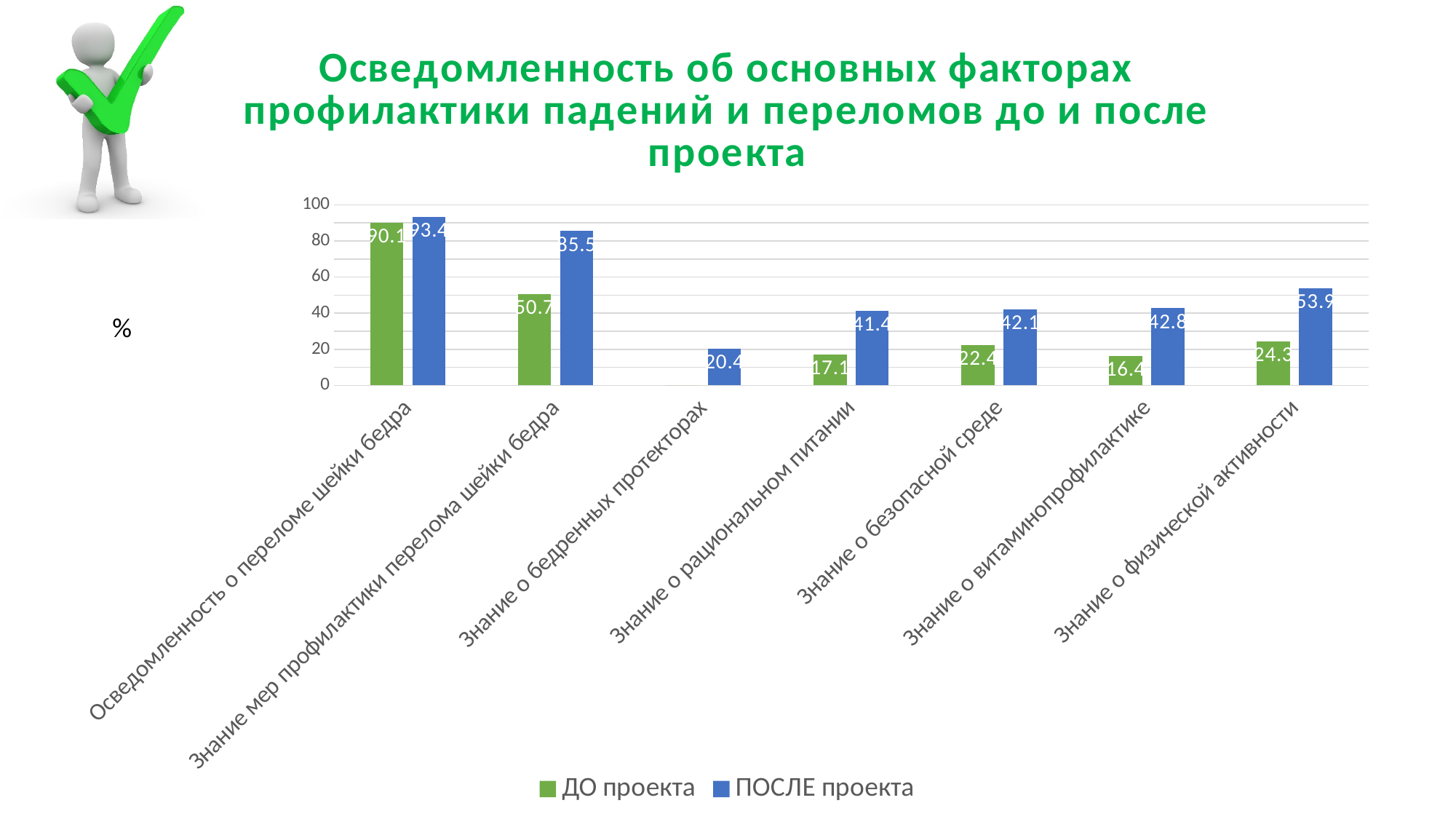
What is the value for "ДО проекта" in the category "Знание о рациональном питании"? 17.1 What kind of chart is shown on the slide? Bar chart Which colour represents the "ПОСЛЕ проекта" series? Blue Which category has the lowest value for "ПОСЛЕ проекта"? Знание о бедренных протекторах What is the value for "ПОСЛЕ проекта" in the category "Знание о бедренных протекторах"? 20.4 Which category has the highest value for "ПОСЛЕ проекта"? Осведомленность о переломе шейки бедра Which is larger: the "ДО проекта" value for "Знание о физической активности" or the "ДО проекта" value for "Знание о витаминопрофилактике"? Знание о физической активности What is the difference between the "ПОСЛЕ проекта" and "ДО проекта" values for "Знание о безопасной среде"? 19.7 What is the value for "ПОСЛЕ проекта" in the category "Знание о физической активности"? 53.9 How many categories are shown on the x axis of the chart? 7 How many series does the legend list? 2 What is the value for "ДО проекта" in the category "Знание мер профилактики перелома шейки бедра"? 50.7